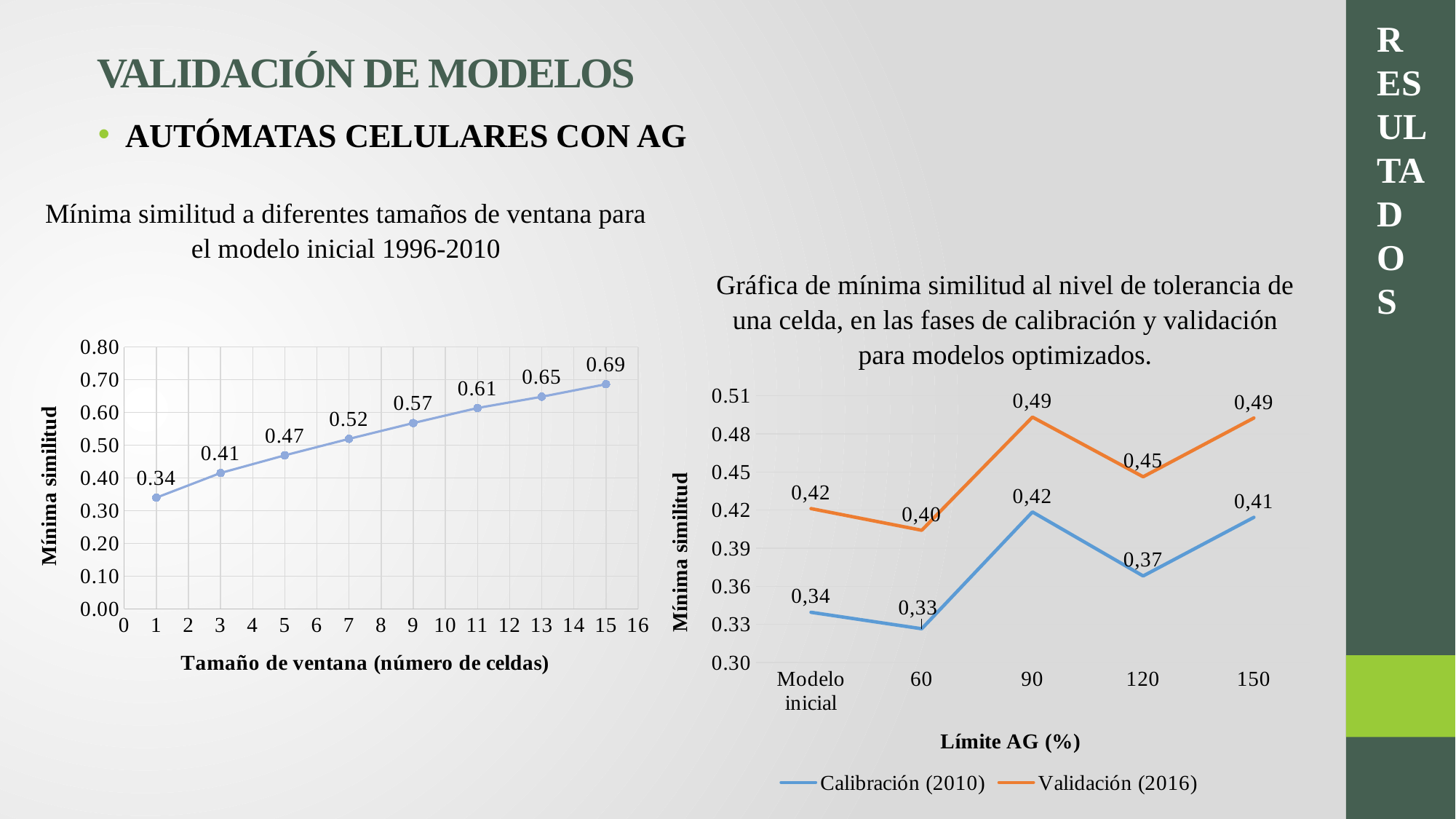
In the left chart (Mínima similitud a diferentes tamaños de ventana), what is the difference between the values at window sizes 15 and 1? 0.35 In the right chart (Gráfica de mínima similitud al nivel de tolerancia de una celda), which category has the lowest Calibración (2010) value? 60 In the left chart (Mínima similitud a diferentes tamaños de ventana), which window size has the highest minimum similarity? 15 In the right chart (Gráfica de mínima similitud al nivel de tolerancia de una celda), what is the Validación (2016) value at Límite AG 120%? 0,45 In the left chart (Mínima similitud a diferentes tamaños de ventana), how many data points are plotted? 8 In the left chart (Mínima similitud a diferentes tamaños de ventana), which window size has the lowest minimum similarity? 1 What kind of chart is the right chart (Gráfica de mínima similitud al nivel de tolerancia de una celda)? line chart In the right chart (Gráfica de mínima similitud al nivel de tolerancia de una celda), what is the Calibración (2010) value at Límite AG 90%? 0,42 In the right chart (Gráfica de mínima similitud al nivel de tolerancia de una celda), how many series does the legend list? 2 In the left chart (Mínima similitud a diferentes tamaños de ventana), does the minimum similarity rise or fall as the window size increases? rise In the left chart (Mínima similitud a diferentes tamaños de ventana), what is the minimum similarity for a window size of 7 cells? 0.52 In the right chart (Gráfica de mínima similitud al nivel de tolerancia de una celda), what is the difference between the Validación (2016) and Calibración (2010) values at Límite AG 150%? 0,08